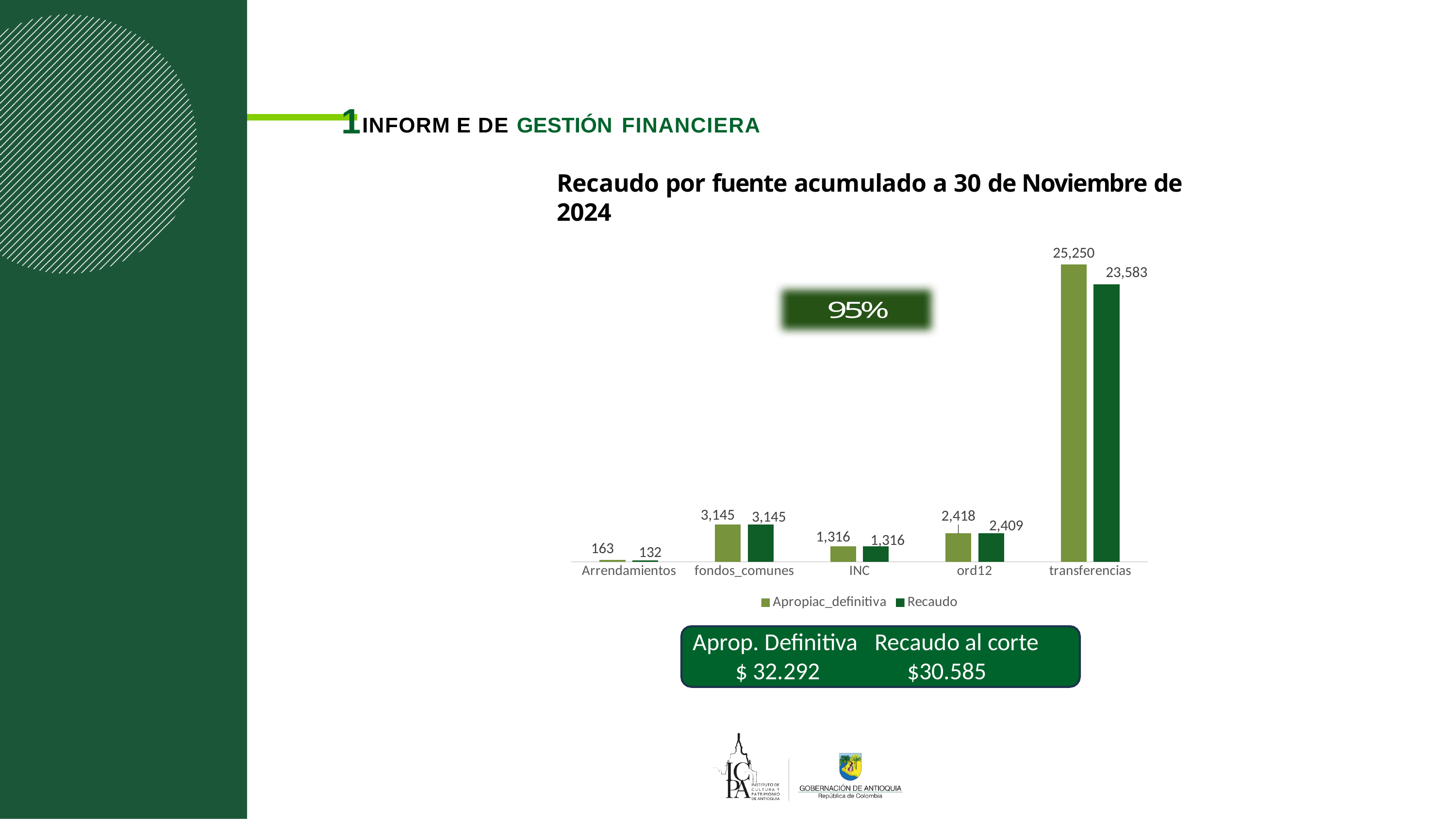
How many categories are shown on the x axis? 5 What is the difference between the Apropiac_definitiva and Recaudo values for transferencias? 1,667 What is the difference between the Apropiac_definitiva and Recaudo values for Arrendamientos? 31 Which category has the lowest Apropiac_definitiva value? Arrendamientos What type of chart is shown on the slide? Bar chart How many series does the legend list? 2 Which is larger: the Recaudo value for INC or the Recaudo value for ord12? ord12 Which category has the highest Recaudo value? transferencias What is the Recaudo value for ord12? 2,409 Which is larger for fondos_comunes: the Apropiac_definitiva value or the Recaudo value? They are equal (3,145) What is the Apropiac_definitiva value for transferencias? 25,250 What is the Recaudo value for Arrendamientos? 132